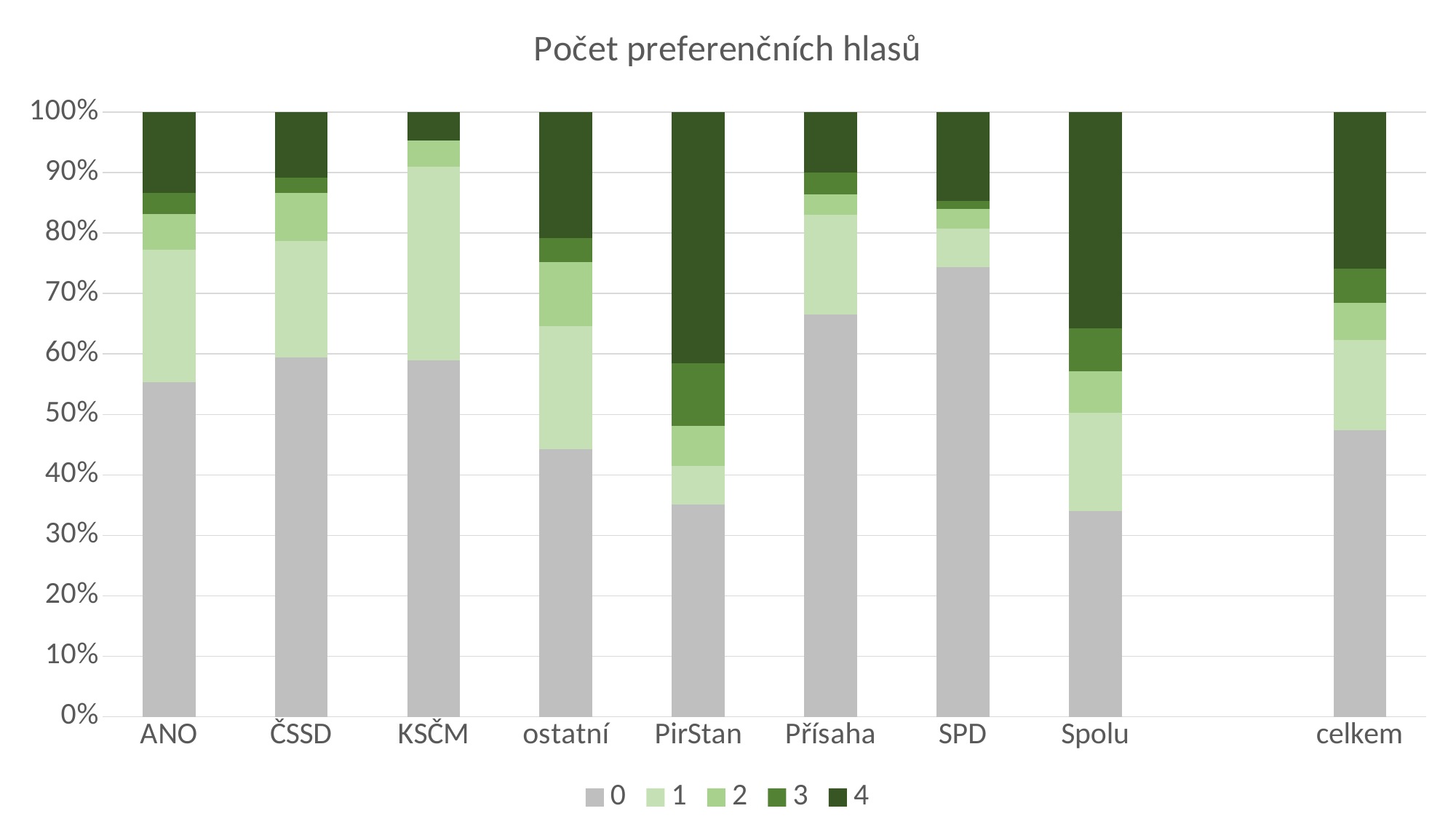
Is the share for series 0 in SPD greater or less than 70%? greater Is the share for series 0 in celkem greater or less than 50%? less What is the title of the chart? Počet preferenčních hlasů What kind of chart is shown on the slide? stacked bar chart How many series does the legend list? 5 Which has the larger share for series 0, SPD or Spolu? SPD What does each stacked bar total? 100% Which category has the largest share for series 4? PirStan Which category has the largest share for series 0? SPD How many categories are shown on the x axis? 9 Is the share for series 0 in Spolu greater or less than 40%? less